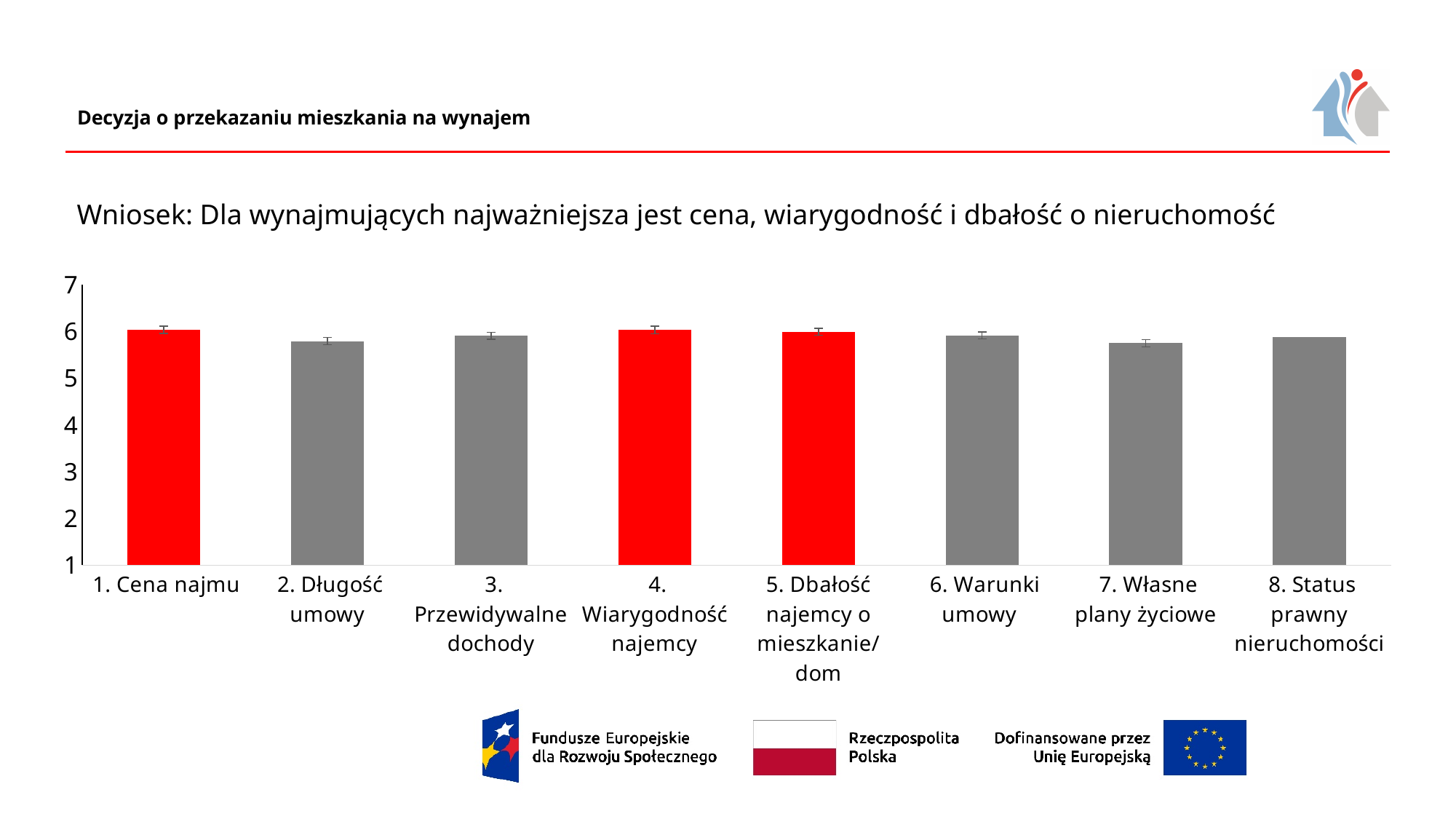
Which categories are highlighted with red bars in the chart? 1. Cena najmu, 4. Wiarygodność najemcy, 5. Dbałość najemcy o mieszkanie/dom What kind of chart is shown on the slide? bar chart Is the value for "7. Własne plany życiowe" greater or less than 6? less Is the value for "4. Wiarygodność najemcy" greater or less than 7? less Is the value for "2. Długość umowy" greater or less than 6? less What is the highest value shown on the y axis of the chart? 7 How many categories are shown on the x axis of the chart? 8